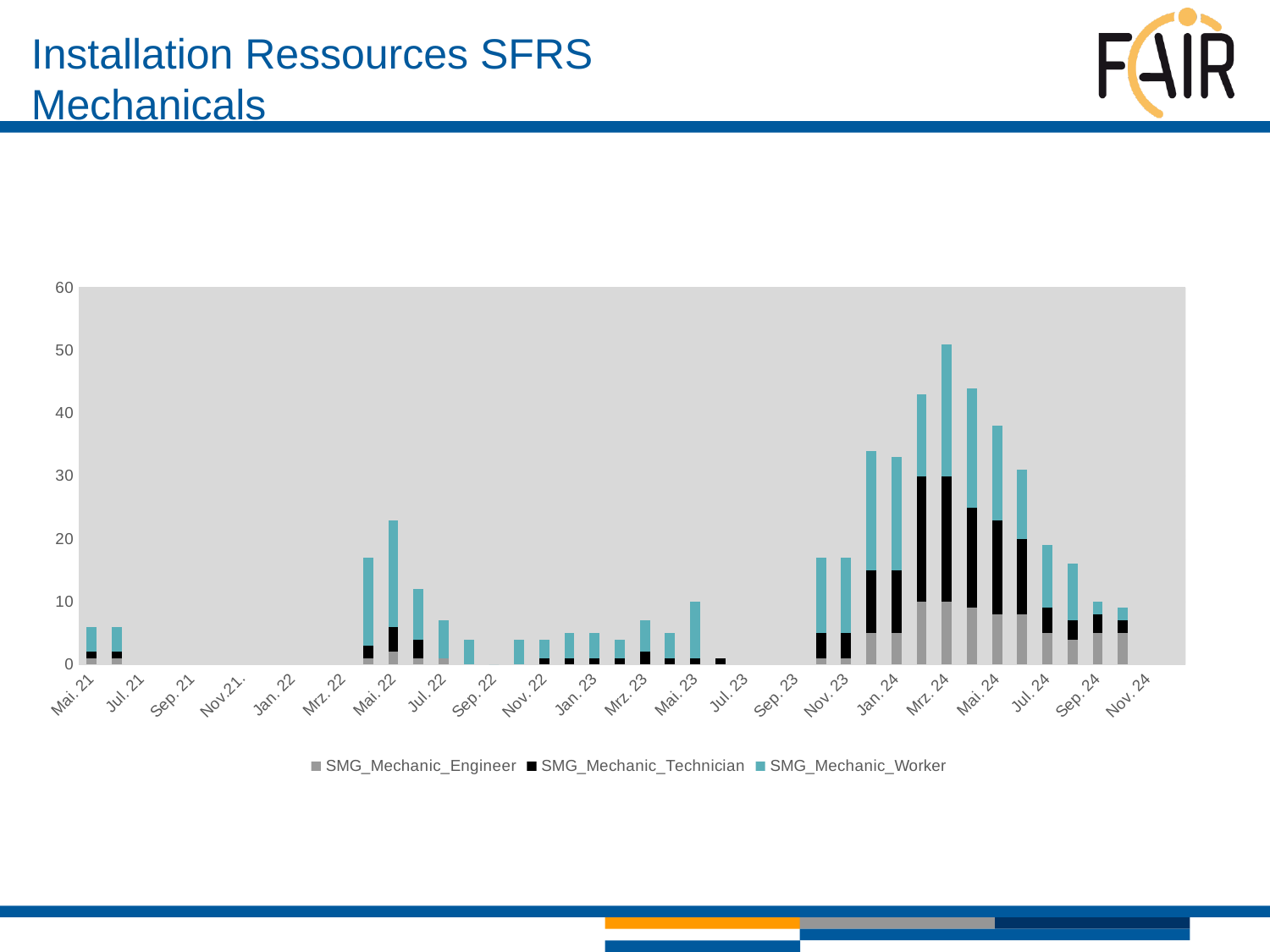
Which series forms the top segment of each stacked bar? SMG_Mechanic_Worker How many series does the legend list? 3 Which period has larger stacked totals: the months around Mai. 21 or the months around Mrz. 24? the months around Mrz. 24 How many month labels are shown on the x axis? 22 Do the stacked totals rise or fall from the peak in early 2024 to Nov. 24? fall Which series is shown in black in the legend? SMG_Mechanic_Technician Is the tallest stacked bar on the chart greater or less than 40? greater Does any stacked bar reach the 60 line on the y axis? No What is the highest value shown on the y axis? 60 What kind of chart is shown on the slide? stacked bar chart Is the total for Mai. 21 greater or less than 10? less